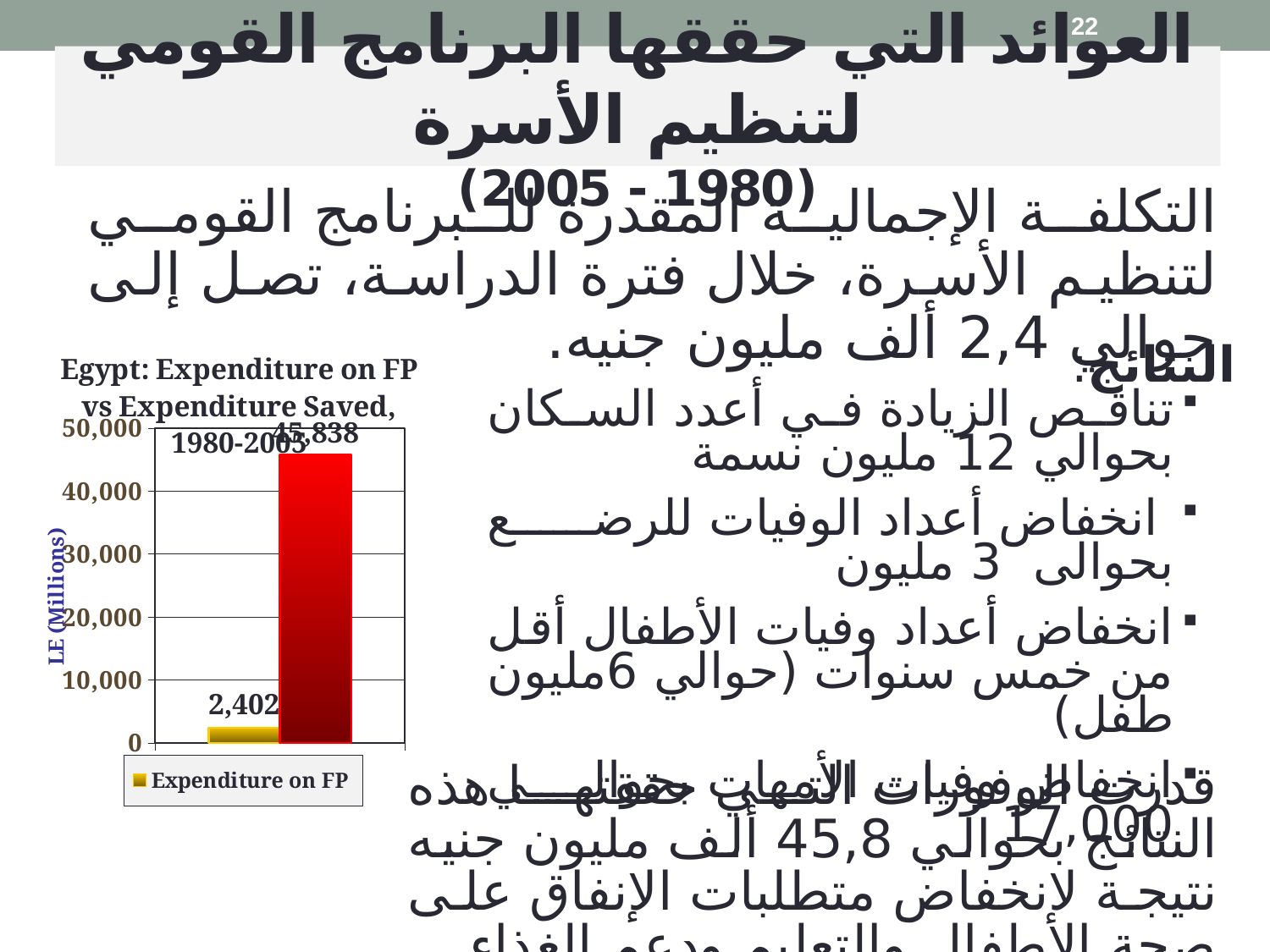
Is the value for Expenditure on FP greater or less than 10,000? less What is the value of the Expenditure on FP bar in the chart? 2,402 What is the difference between the red bar (45,838) and the Expenditure on FP bar (2,402)? 43,436 Is the value of the red bar greater or less than 40,000? greater What type of chart is shown on the slide? Bar chart How many bars are plotted in the chart? 2 Which bar in the chart has the lowest value? Expenditure on FP What time period is stated in the chart title? 1980-2005 What is the value shown on the red bar in the chart? 45,838 What is the label of the vertical axis of the chart? LE (Millions) Which bar is larger, the red bar or the Expenditure on FP bar? The red bar